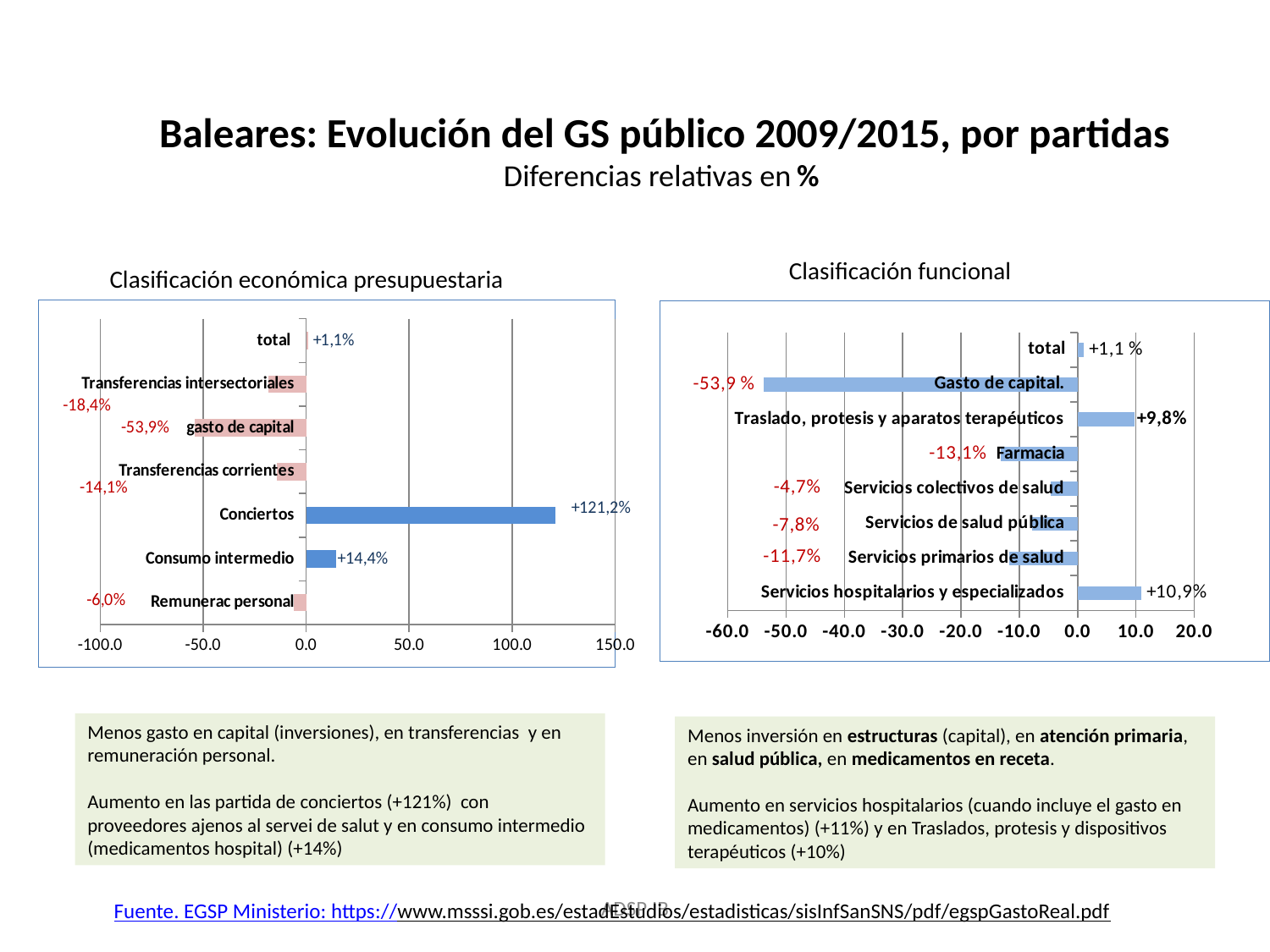
In the 'Clasificación económica presupuestaria' chart, which category has the highest value? Conciertos In the 'Clasificación funcional' chart, which is larger, the value for Servicios de salud pública or the value for Servicios primarios de salud? Servicios de salud pública In the 'Clasificación funcional' chart, which category has the highest value? Servicios hospitalarios y especializados In the 'Clasificación económica presupuestaria' chart, how many categories are plotted? 7 In the 'Clasificación funcional' chart, what is the value for Farmacia? -13,1% In the 'Clasificación funcional' chart, what is the value for Servicios hospitalarios y especializados? +10,9% In the 'Clasificación económica presupuestaria' chart, which category has the lowest value? gasto de capital In the 'Clasificación funcional' chart, how many categories are plotted? 8 In the 'Clasificación económica presupuestaria' chart, what is the difference between the values for Consumo intermedio and Remunerac personal? 20,4 percentage points What type of chart is the 'Clasificación funcional' chart? Bar chart In the 'Clasificación económica presupuestaria' chart, what is the value for gasto de capital? -53,9% In the 'Clasificación económica presupuestaria' chart, what is the value for Conciertos? +121,2%